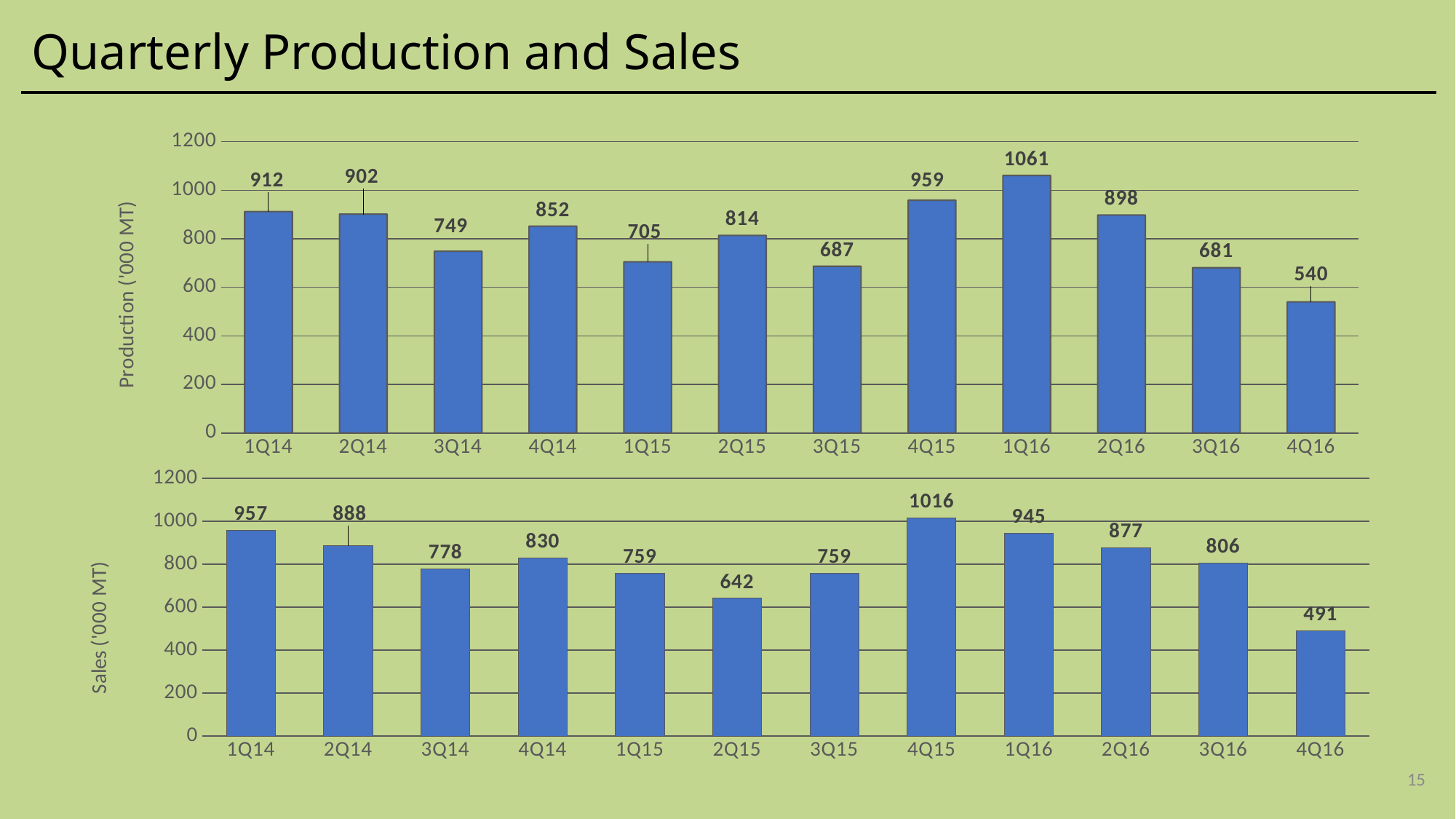
In the bottom chart (Sales), what is the difference between sales in 1Q14 and 2Q14? 69 In the top chart (Production), does production rise or fall from 1Q16 to 4Q16? fall In the top chart (Production), which is larger: production in 4Q14 or 2Q15? 4Q14 What type of chart is the bottom chart (Sales)? bar chart In the top chart (Production), what is the difference between production in 1Q16 and 4Q16? 521 In the top chart (Production), what is the production value for 1Q16? 1061 In the bottom chart (Sales), which quarter has the highest sales? 4Q15 How many quarters are shown on the x axis of the top chart (Production)? 12 In the top chart (Production), which quarter has the lowest production? 4Q16 What is the y-axis label of the bottom chart? Sales ('000 MT) In the bottom chart (Sales), is the value for 3Q16 greater or less than 1000? less In the bottom chart (Sales), what is the sales value for 2Q15? 642